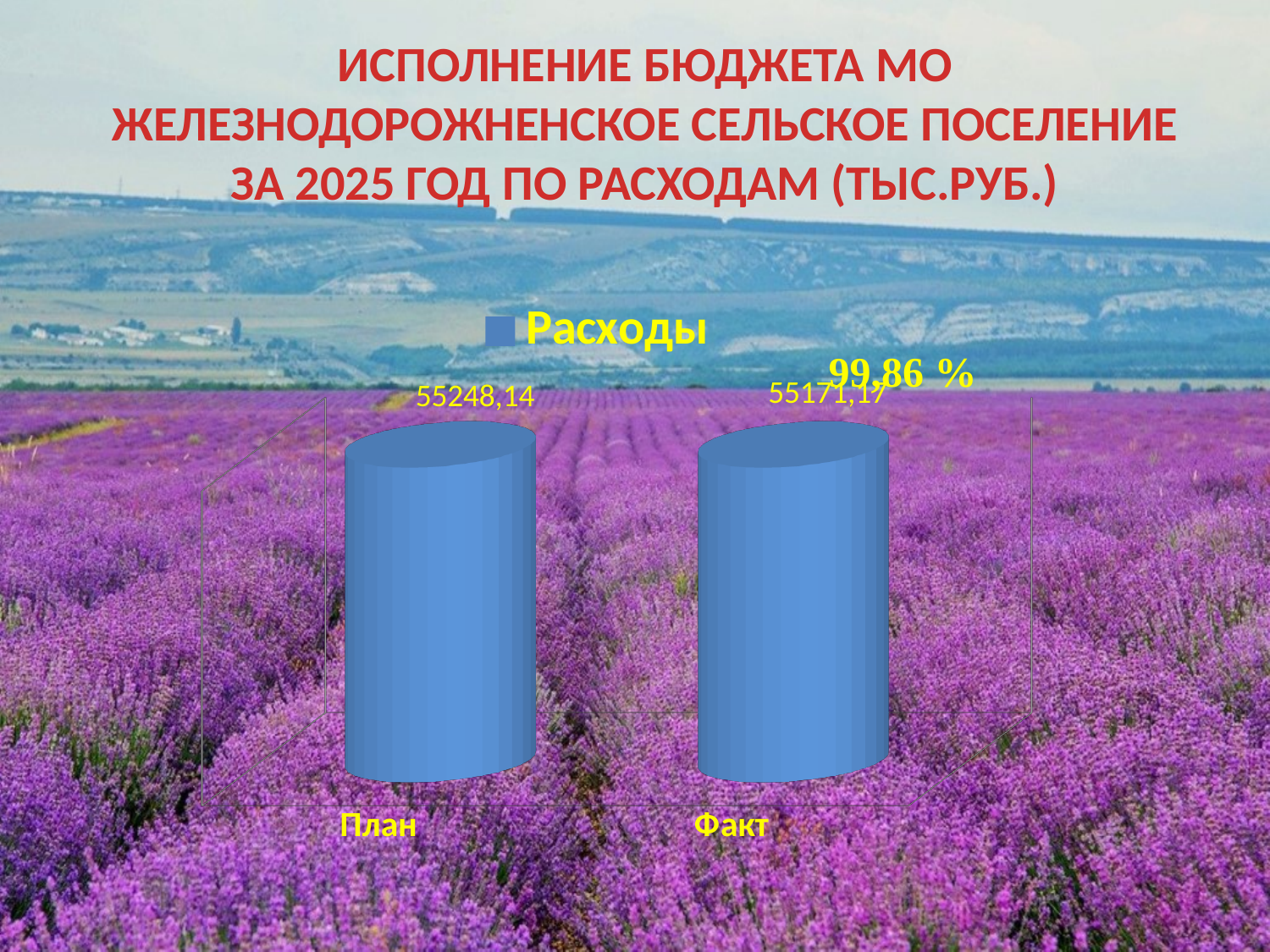
What is the value for План in the chart? 55248,14 What percentage is printed above the Факт bar? 99,86 % What series name is shown in the chart legend? Расходы What are the two category labels on the x axis of the chart? План, Факт How many series does the chart legend list? 1 What kind of chart is shown on the slide? bar chart How many categories are plotted in the chart? 2